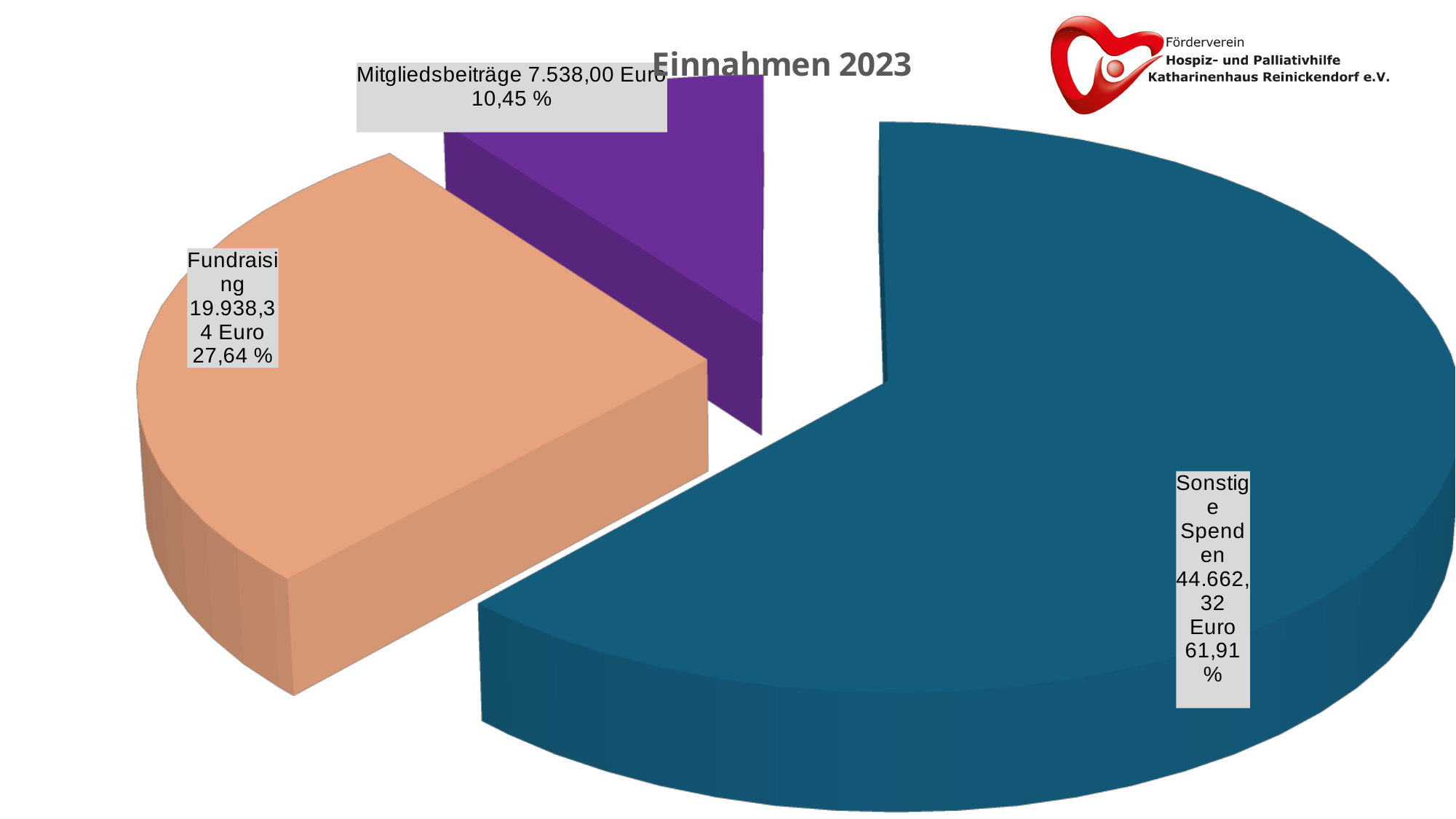
What kind of chart is shown on the slide? pie chart Which category has the smallest value? Mitgliedsbeiträge Which is larger, Fundraising or Mitgliedsbeiträge? Fundraising What share of the pie does Sonstige Spenden represent? 61,91 % What is the value for Sonstige Spenden? 44.662,32 Euro How many slices does the pie chart have? 3 What is the value for Fundraising? 19.938,34 Euro Which category has the largest value? Sonstige Spenden What is the value for Mitgliedsbeiträge? 7.538,00 Euro What share of the pie does Mitgliedsbeiträge represent? 10,45 % What share of the pie does Fundraising represent? 27,64 % What is the title of the chart? Einnahmen 2023